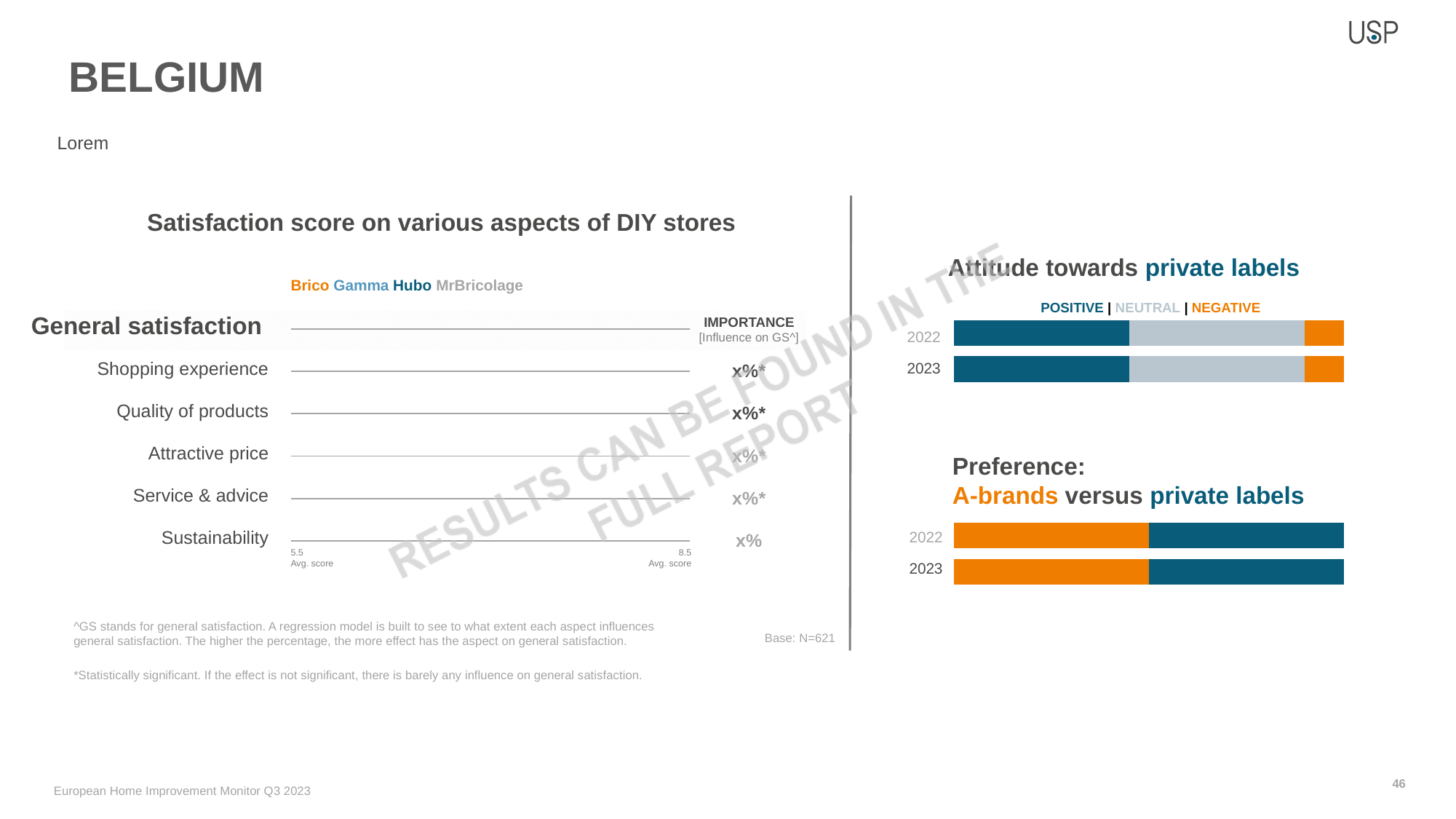
What kind of chart is the 'Attitude towards private labels' chart? Stacked bar chart In the 'Attitude towards private labels' chart, how many years are shown? 2 In the 'Satisfaction score on various aspects of DIY stores' chart, how many aspects are listed below 'General satisfaction'? 5 In the 'Attitude towards private labels' chart, is the positive share or the negative share larger in 2023? Positive What kind of chart is the 'Preference: A-brands versus private labels' chart? Stacked bar chart In the 'Attitude towards private labels' chart, how many attitude categories does the legend list? 3 In the 'Preference: A-brands versus private labels' chart, how many years are shown? 2 In the 'Satisfaction score on various aspects of DIY stores' chart, what are the minimum and maximum average scores shown on the axis? 5.5 and 8.5 In the 'Attitude towards private labels' chart, which attitude has the smallest share in 2023? Negative In the 'Attitude towards private labels' chart, which attitude has the smallest share in 2022? Negative In the 'Satisfaction score on various aspects of DIY stores' chart, which stores are listed in the legend? Brico, Gamma, Hubo, MrBricolage In the 'Satisfaction score on various aspects of DIY stores' chart, how many DIY stores does the legend list? 4